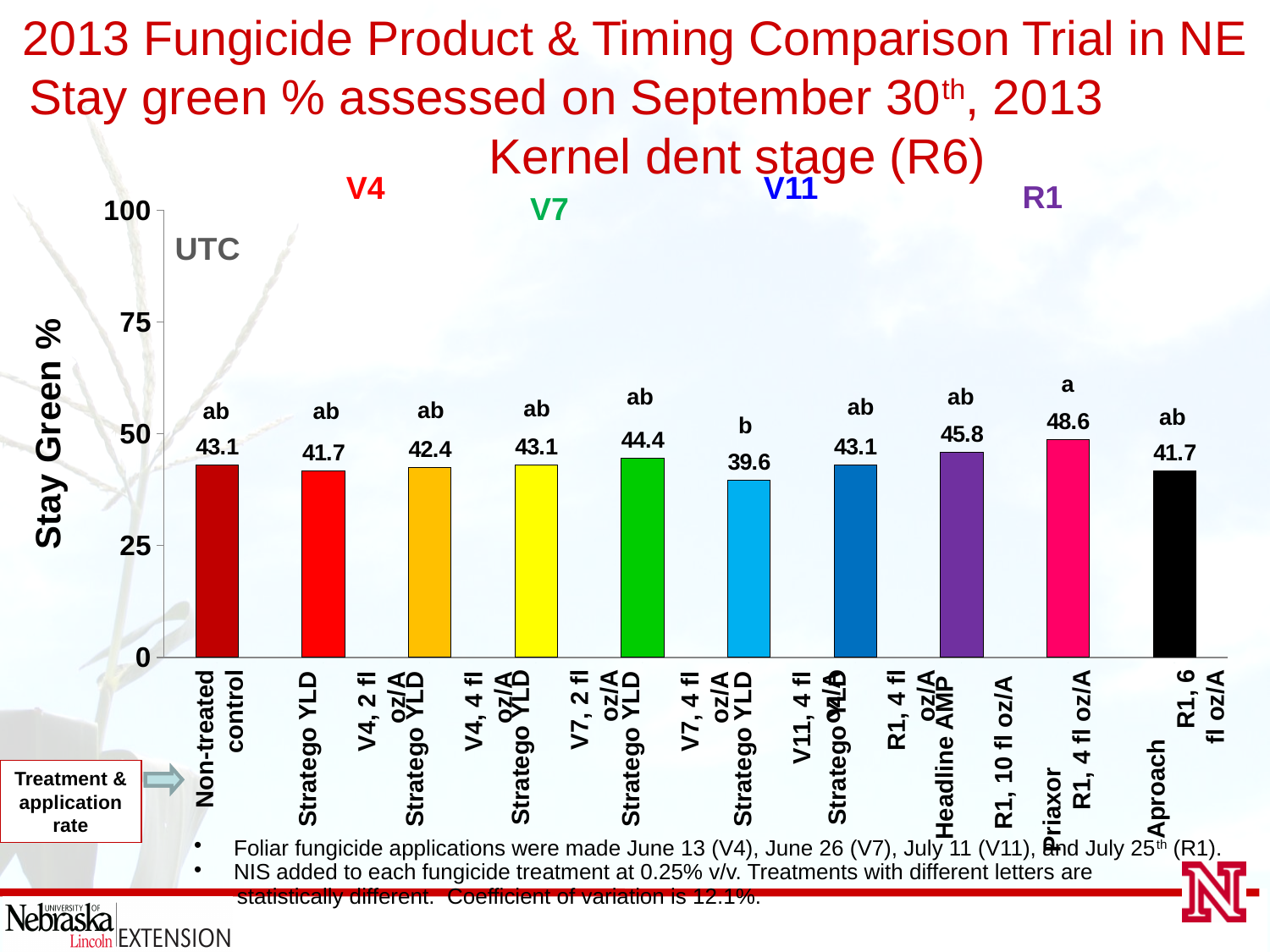
What is the difference in Stay Green % between Priaxor (R1, 4 fl oz/A) and the Non-treated control? 5.5 How many treatment bars are shown in the chart? 10 Which treatment has the highest Stay Green %? Priaxor, R1, 4 fl oz/A What type of chart is shown on the slide? Bar chart Which treatment has the lowest Stay Green %? Stratego YLD, V11, 4 fl oz/A What is the Stay Green % for the Non-treated control? 43.1 Which has a higher Stay Green %: Headline AMP (R1, 10 fl oz/A) or Stratego YLD (V7, 4 fl oz/A)? Headline AMP (R1, 10 fl oz/A) What is the Stay Green % for Stratego YLD applied at V11, 4 fl oz/A? 39.6 What is the Stay Green % for Priaxor applied at R1, 4 fl oz/A? 48.6 Which treatment is the only one labelled with the statistical letter 'a'? Priaxor, R1, 4 fl oz/A What is the Stay Green % for Headline AMP applied at R1, 10 fl oz/A? 45.8 Is the Stay Green % for Aproach (R1, 6 fl oz/A) greater or less than 50? less